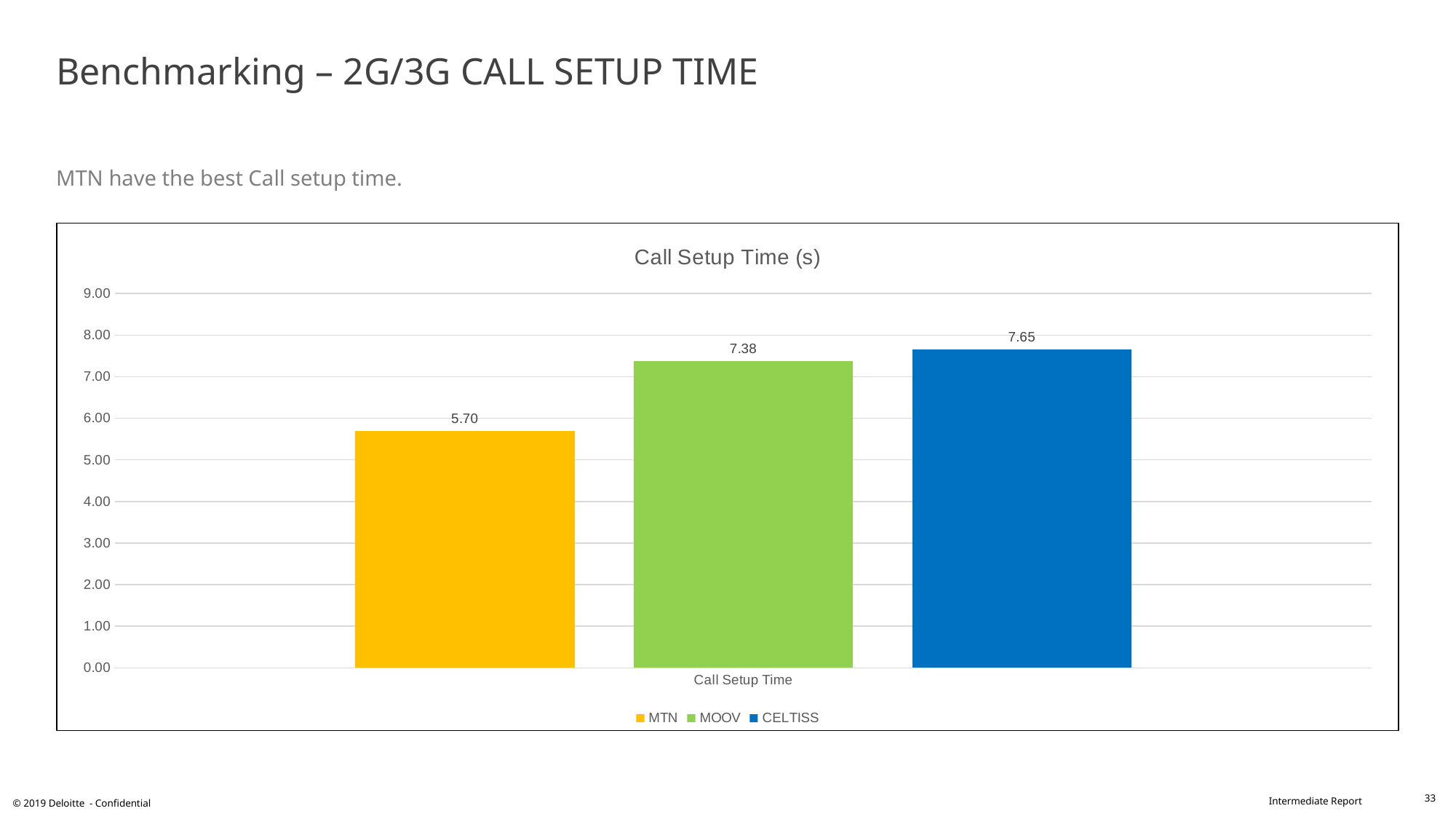
Is the Call Setup Time for MTN greater or less than 6.00? less What is the Call Setup Time (s) for MTN? 5.70 What is the difference in Call Setup Time between CELTISS and MTN? 1.95 Which has a larger Call Setup Time, MOOV or MTN? MOOV What is the Call Setup Time (s) for CELTISS? 7.65 What kind of chart is shown on the slide? bar chart Which operator has the highest Call Setup Time? CELTISS How many series does the legend list? 3 What is the Call Setup Time (s) for MOOV? 7.38 What is the title of the chart? Call Setup Time (s) What is the difference in Call Setup Time between MOOV and MTN? 1.68 Which operator has the lowest Call Setup Time? MTN